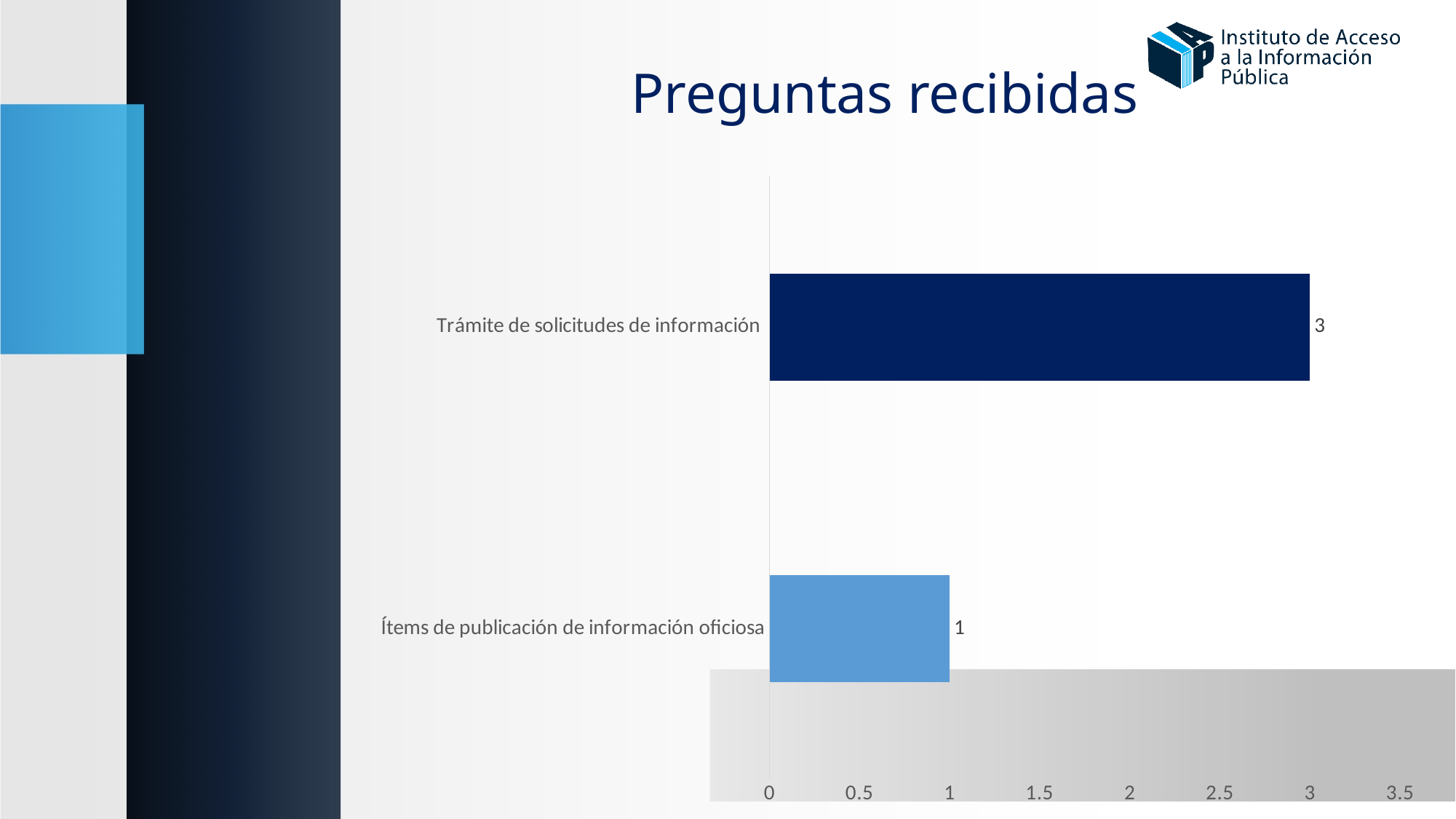
What is the value for Ítems de publicación de información oficiosa? 1 Which category has the lowest value? Ítems de publicación de información oficiosa What is the title of the slide? Preguntas recibidas Is the value for Ítems de publicación de información oficiosa greater or less than 2? less Which category has the highest value? Trámite de solicitudes de información Which is larger: the value for Trámite de solicitudes de información or the value for Ítems de publicación de información oficiosa? Trámite de solicitudes de información What is the highest tick value shown on the horizontal axis? 3.5 Is the value for Trámite de solicitudes de información greater or less than 2? greater How many categories are shown in the chart? 2 What kind of chart is shown on the slide? bar chart What is the difference between the values for Trámite de solicitudes de información and Ítems de publicación de información oficiosa? 2 What is the value for Trámite de solicitudes de información? 3